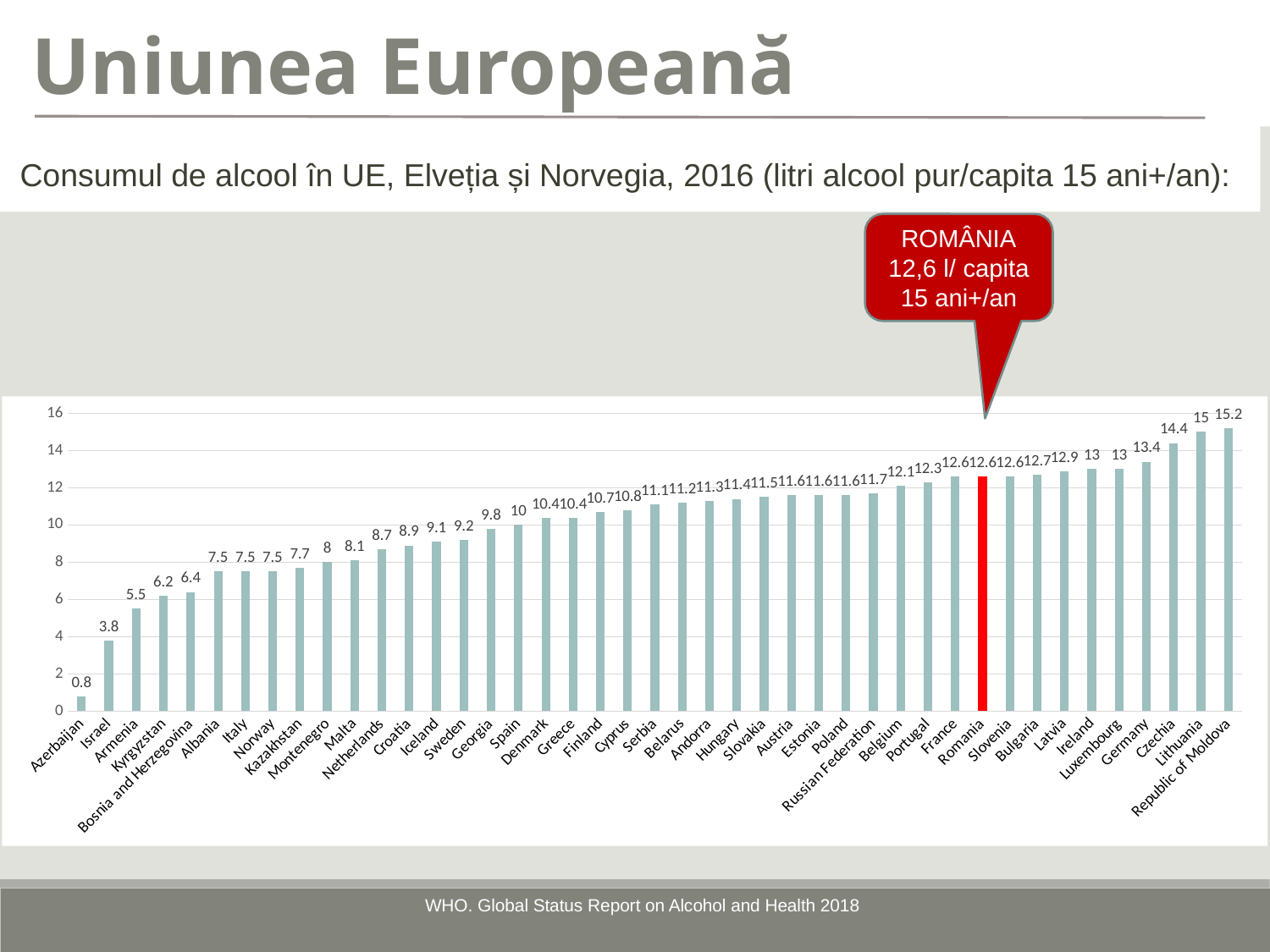
Which has a larger value, Lithuania or Israel? Lithuania What is the value for Germany? 13.4 What is the difference between the values for Czechia and Romania? 1.8 Which country has the highest value? Republic of Moldova What is the value for Romania? 12.6 Which country has the lowest value? Azerbaijan Is the value for Netherlands greater or less than 10? less What is the value for Spain? 10 Do the values rise or fall from left to right along the x axis? rise What is the value for Azerbaijan? 0.8 What is the difference between the values for Republic of Moldova and Azerbaijan? 14.4 What kind of chart is shown on the slide? bar chart